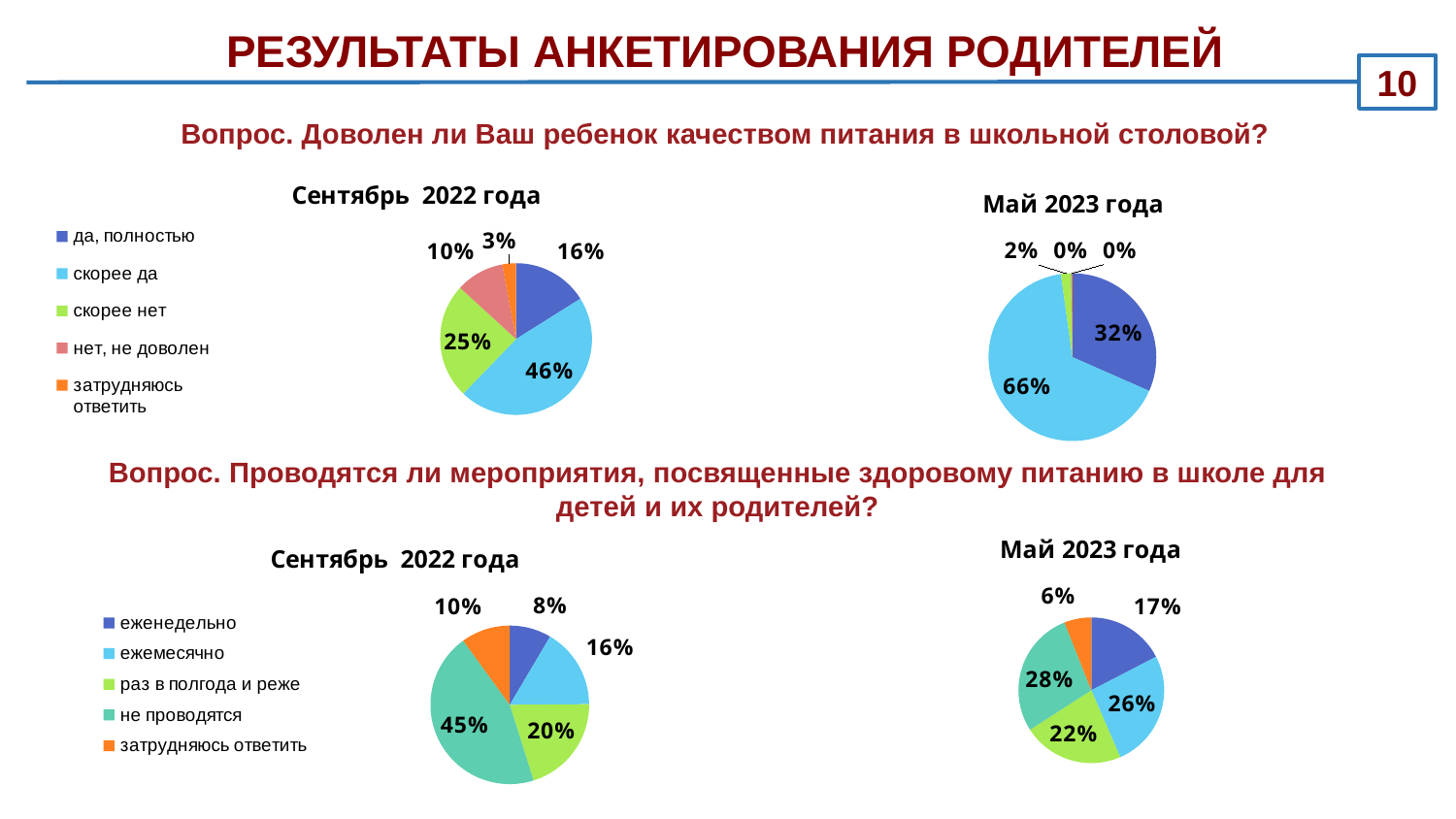
In the top-left pie chart (Сентябрь 2022 года, food quality question), which category has the smallest share? затрудняюсь ответить In the top-right pie chart (Май 2023 года, food quality question), which category has the largest share? скорее да In the top-right pie chart (Май 2023 года, food quality question), what share is labelled for 'да, полностью'? 32% How many categories does the legend list for the bottom pair of pie charts (healthy-eating events question)? 5 In the bottom-left pie chart (Сентябрь 2022 года, healthy-eating events question), what is the difference between the shares for 'не проводятся' and 'ежемесячно'? 29% In the top-left pie chart (Сентябрь 2022 года, food quality question), what is the difference between the shares for 'скорее да' and 'скорее нет'? 21% In the top-left pie chart (Сентябрь 2022 года, food quality question), what share is labelled for 'нет, не доволен'? 10% In the bottom-right pie chart (Май 2023 года, healthy-eating events question), which is larger: the share for 'не проводятся' or the share for 'еженедельно'? не проводятся In the top-left pie chart (Сентябрь 2022 года, question about satisfaction with food quality), what share is labelled for 'скорее да'? 46% In the bottom-left pie chart (Сентябрь 2022 года, question about healthy-eating events), what share is labelled for 'не проводятся'? 45% In the bottom-right pie chart (Май 2023 года, healthy-eating events question), what share is labelled for 'ежемесячно'? 26% What type of chart is used for the Май 2023 года results of the food quality question? Pie chart